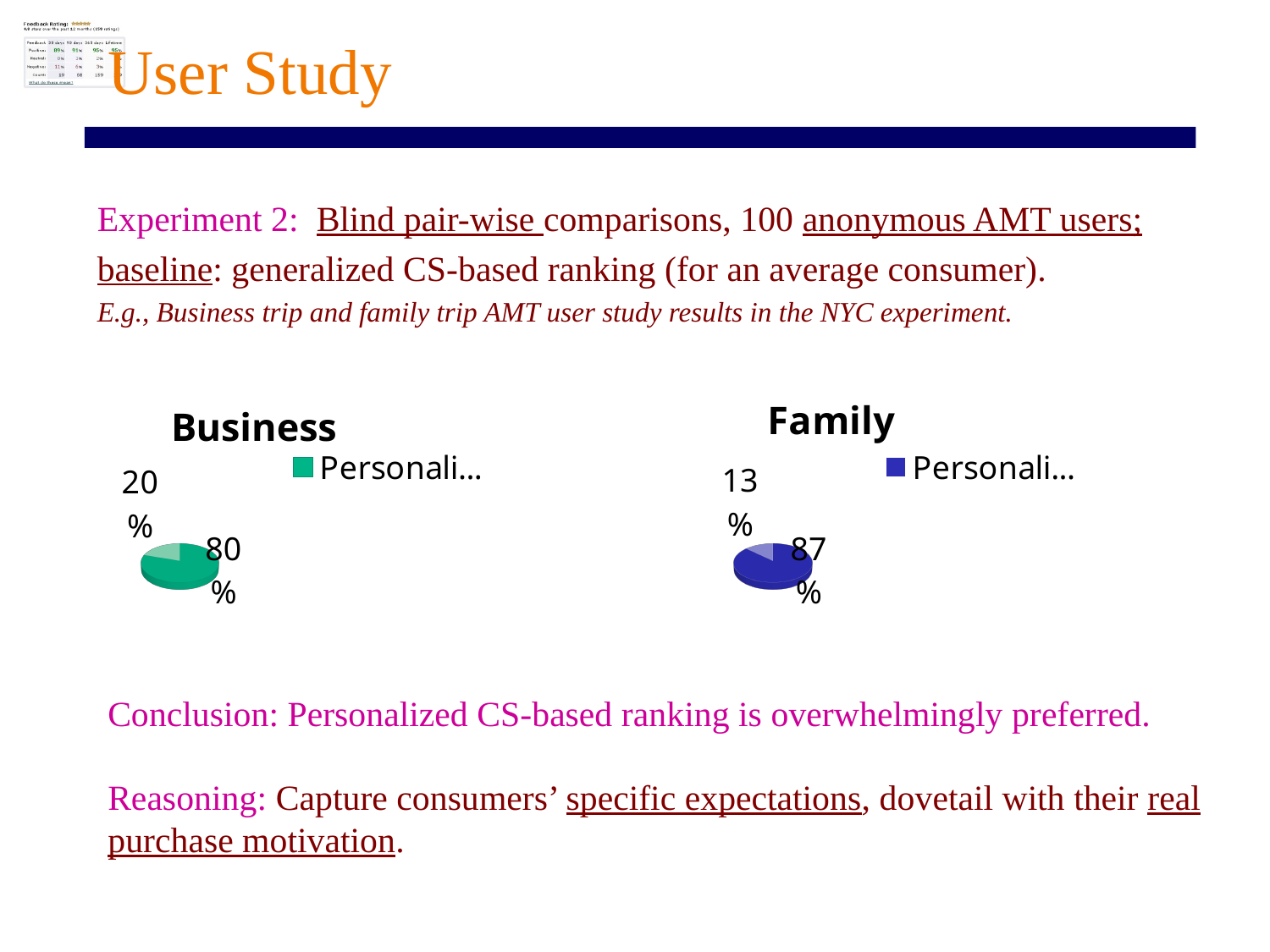
In the Family pie chart, what is the value of the smallest slice? 13% How many slices does the Business pie chart have? 2 What kind of chart is the Business chart? pie chart In the Business pie chart, what is the value of the largest slice? 80% In the Family pie chart, what is the difference between the two slices? 74% In the Business pie chart, what is the value of the smallest slice? 20% What is the title of the pie chart on the left? Business What kind of chart is the Family chart? pie chart Which chart has the larger majority slice, Business or Family? Family How many slices does the Family pie chart have? 2 In the Business pie chart, what is the difference between the two slices? 60% In the Family pie chart, what is the value of the largest slice? 87%